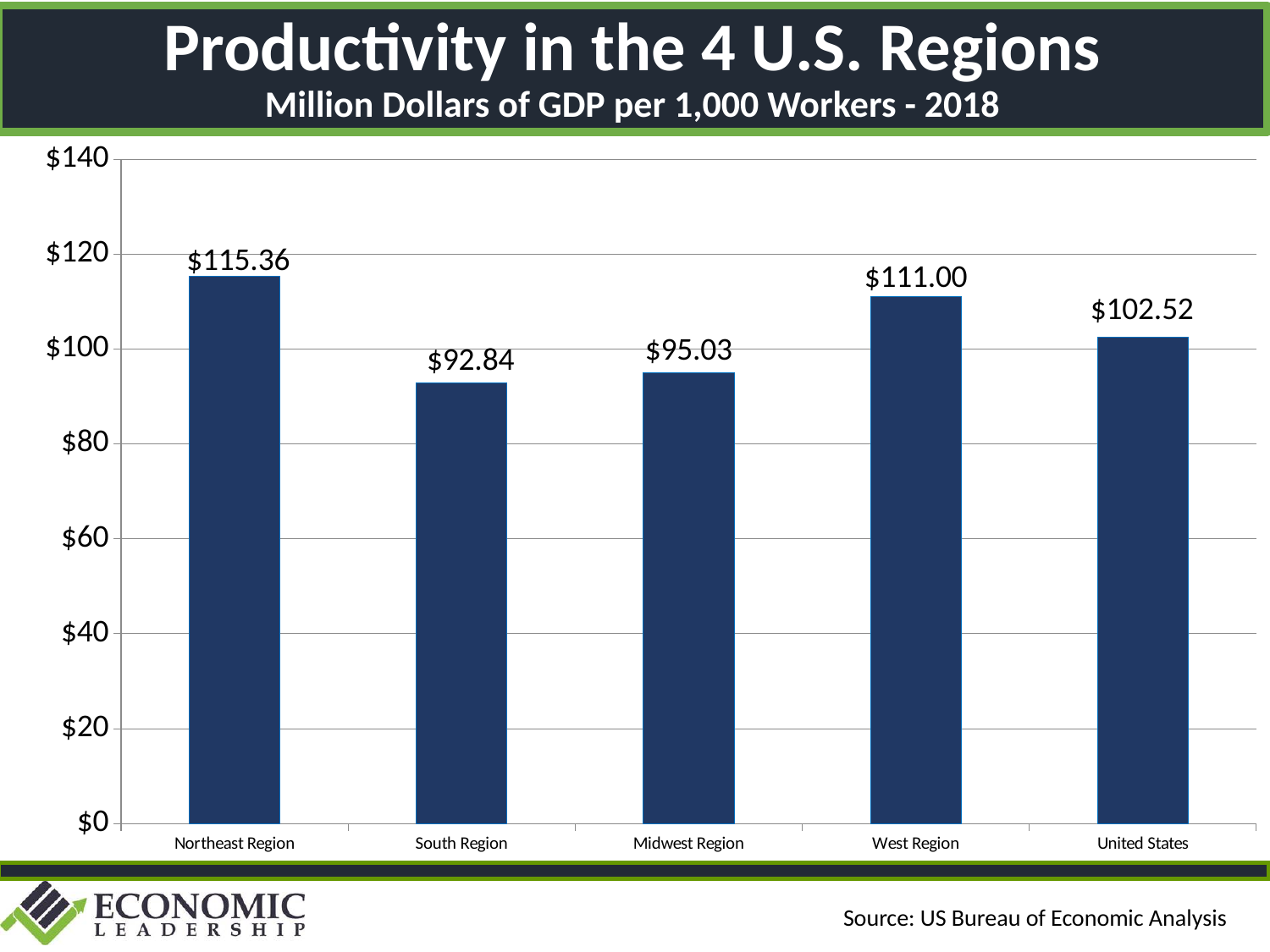
What is the difference between the Northeast Region and the West Region values? $4.36 What is the value for the Northeast Region? $115.36 Which category has the highest value? Northeast Region Which category has the lowest value? South Region Is the value for the Midwest Region greater or less than $100? less What is the difference between the Midwest Region and the South Region values? $2.19 What is the value for the United States? $102.52 What is the value for the South Region? $92.84 How many categories are shown on the x axis? 5 What is the subtitle of the chart? Million Dollars of GDP per 1,000 Workers - 2018 What kind of chart is shown on the slide? bar chart Which is larger, the value for the West Region or the value for the United States? West Region